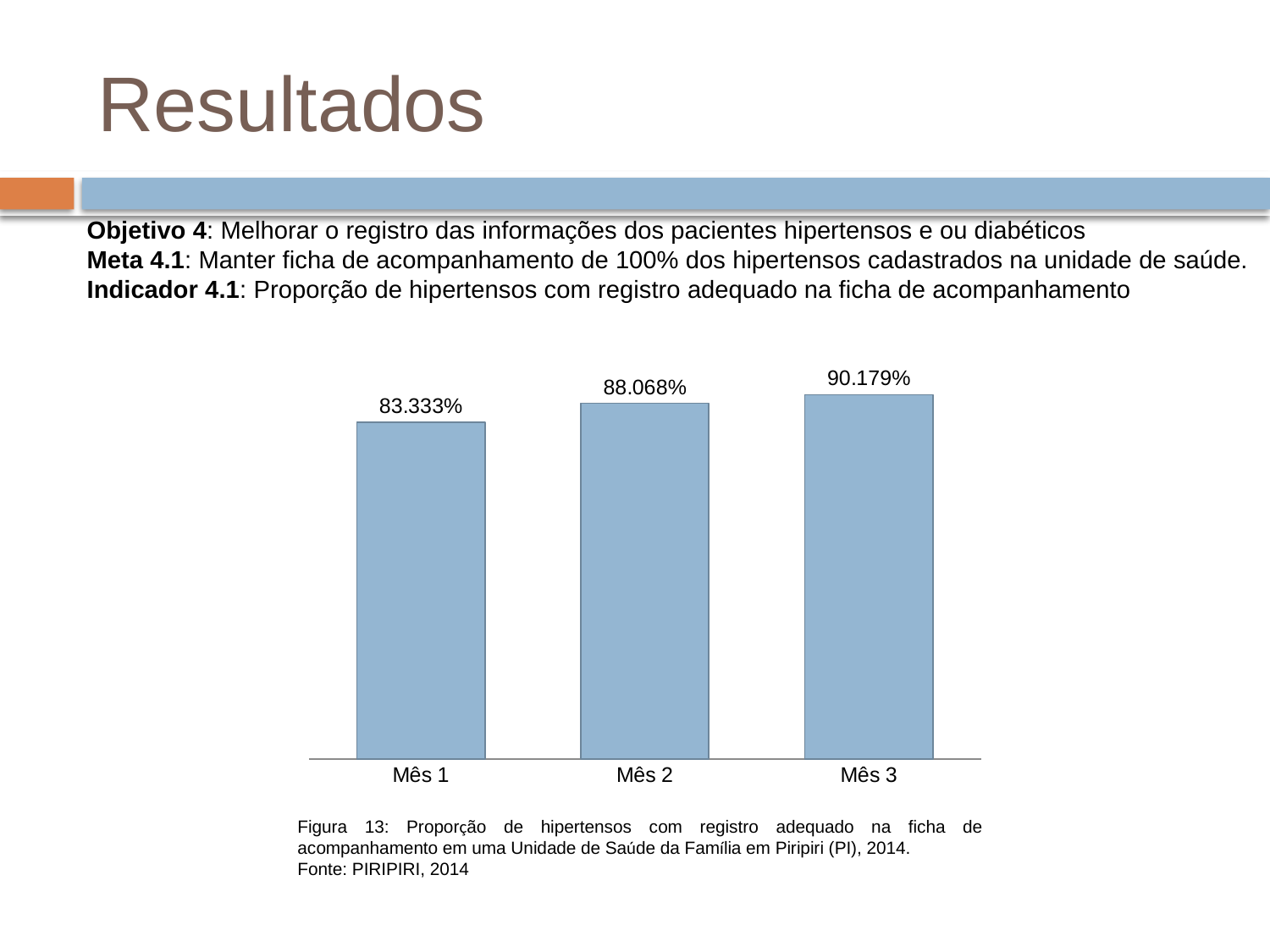
What is the figure number given in the caption below the chart? Figura 13 What is the difference between the values for Mês 3 and Mês 1? 6.846% How many months are shown on the x axis? 3 What is the difference between the values for Mês 2 and Mês 1? 4.735% What is the value for Mês 2? 88.068% What is the value for Mês 1? 83.333% Do the values rise or fall from Mês 1 to Mês 3? Rise What kind of chart is shown on the slide? Bar chart Which month has the lowest value? Mês 1 Which month has the highest value? Mês 3 What is the value for Mês 3? 90.179% Which is larger, the value for Mês 2 or the value for Mês 3? Mês 3